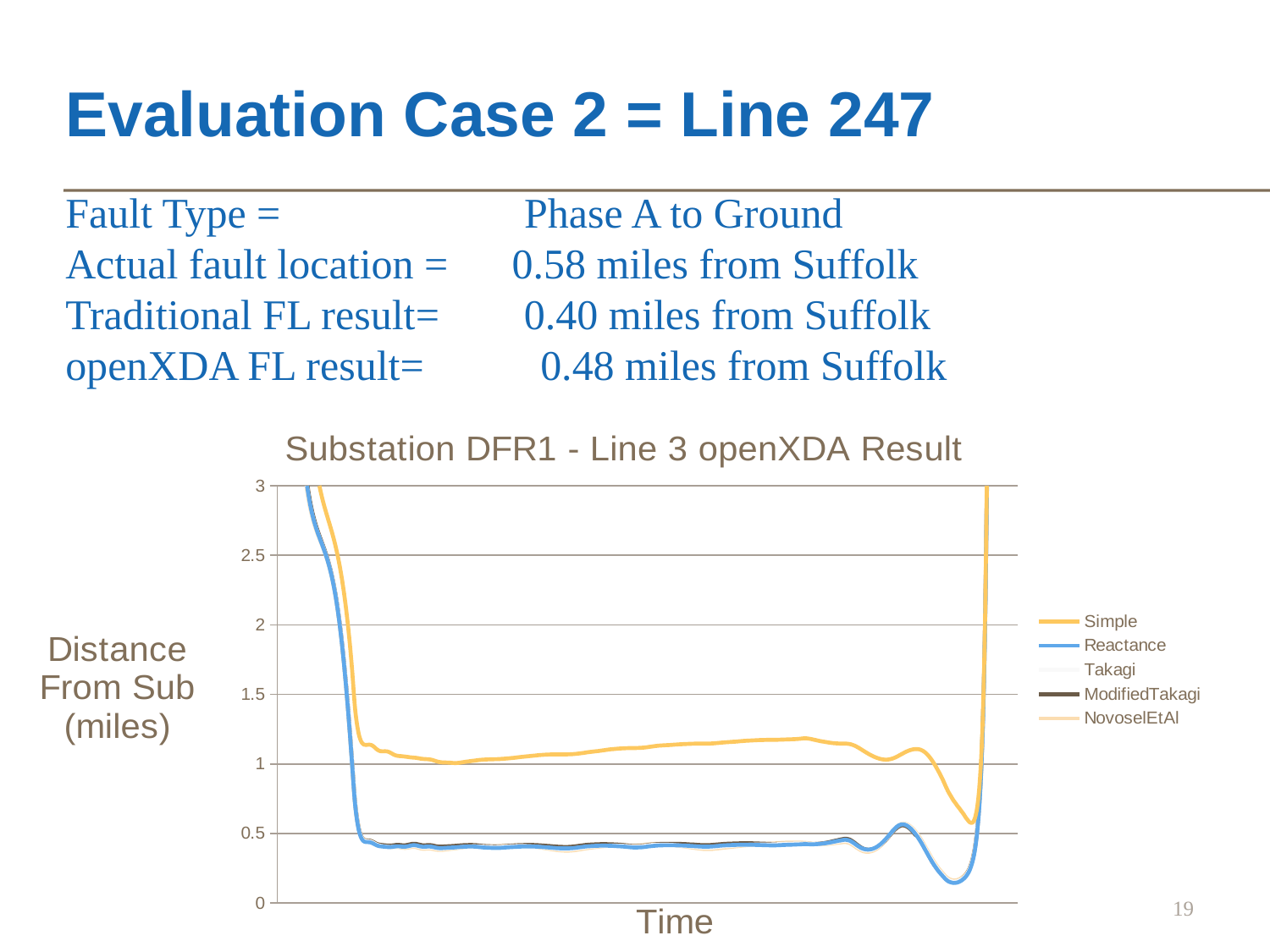
During the flat middle portion of the chart, is the Simple series greater or less than 2? less What is the title of the chart? Substation DFR1 - Line 3 openXDA Result What is the label of the x axis of the chart? Time During the flat middle portion of the chart, is the Simple series greater or less than 0.5? greater Which series is drawn in yellow/orange in the chart? Simple How many series does the chart legend list? 5 Do the plotted lines rise or fall at the start of the time axis? fall What is the highest value shown on the y axis of the chart? 3 In the middle portion of the chart, which series has the higher value, Simple or Reactance? Simple What kind of chart is shown on the slide? line chart During the flat middle portion of the chart, is the Reactance series greater or less than 1? less Which series is drawn in blue in the chart? Reactance